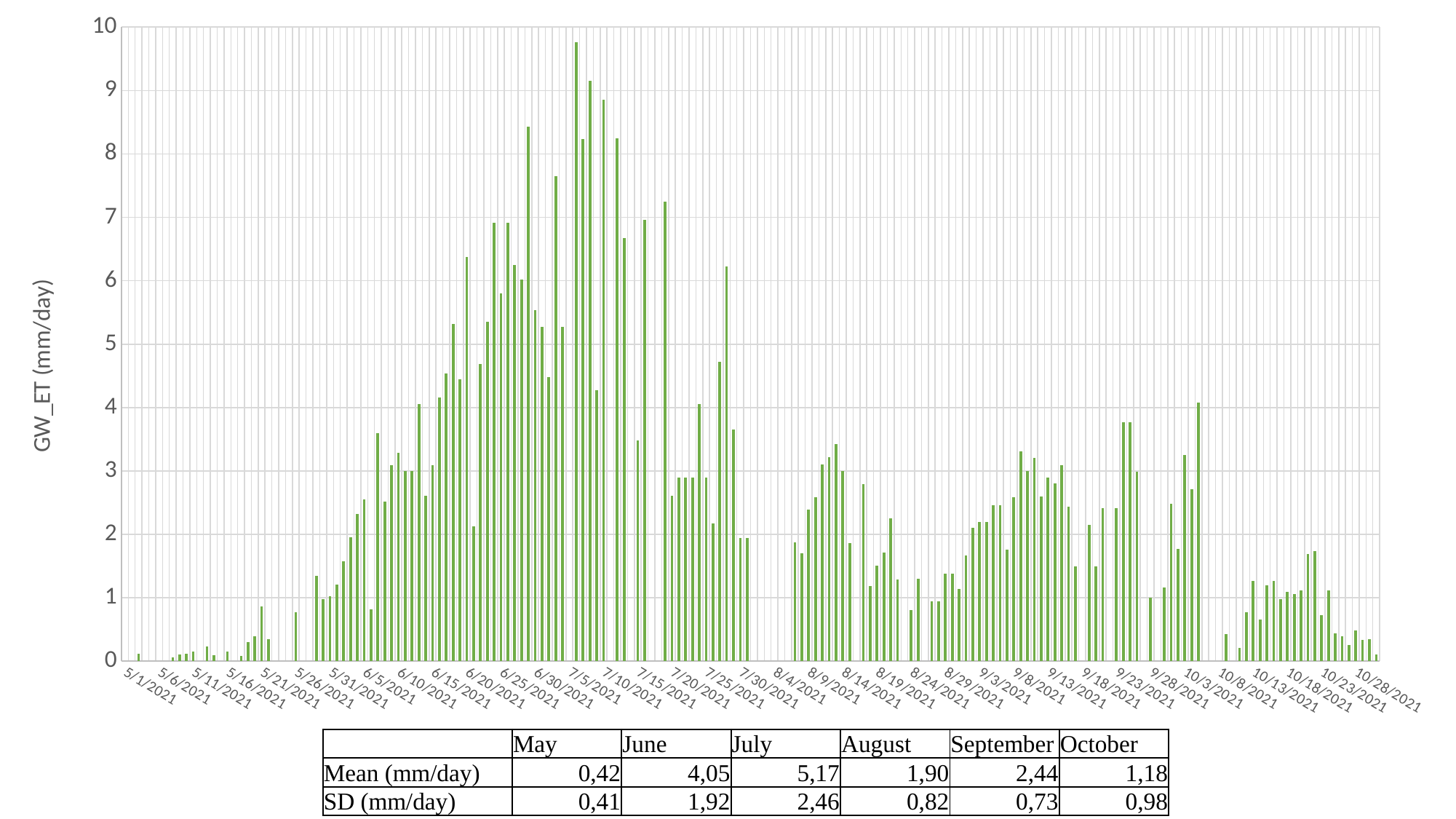
According to the table below the chart, which month has the highest mean GW_ET? July According to the table below the chart, which month has the lowest mean GW_ET? May According to the table below the chart, what is the mean GW_ET for July? 5,17 What kind of chart is shown on the slide? bar chart What is the highest value shown on the vertical axis of the chart? 10 According to the table below the chart, what is the difference between the mean GW_ET for July and for June? 1,12 According to the table below the chart, which month has the larger SD, June or July? July Is the value for 10/28/2021 greater or less than 1? less Is the tallest bar in the chart greater or less than 9? greater What is the label on the vertical axis of the chart? GW_ET (mm/day) Do the daily GW_ET values generally rise or fall between 7/5/2021 and 7/30/2021? fall